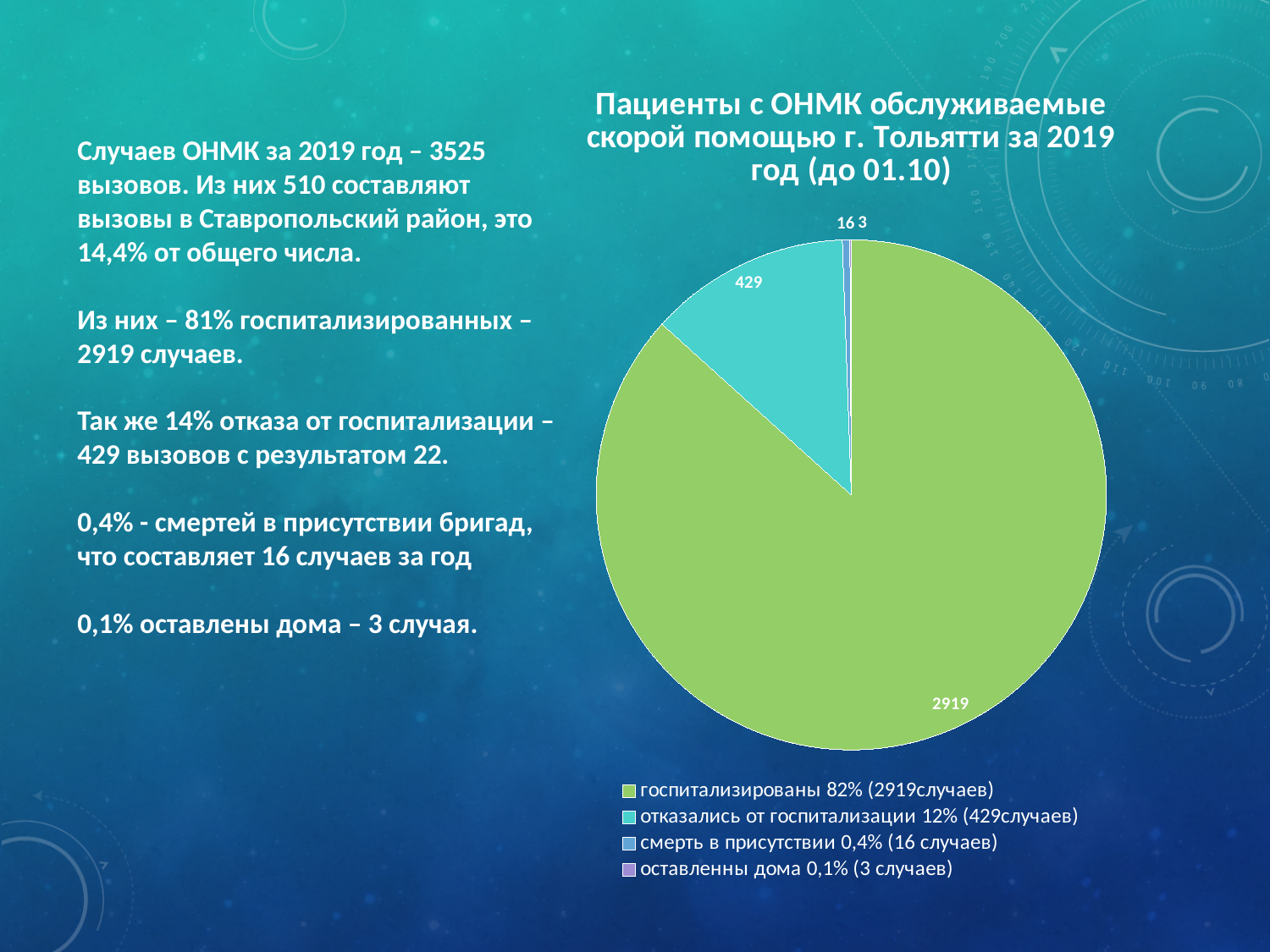
What is the value shown for the 'оставленны дома' slice? 3 What is the title of the pie chart? Пациенты с ОНМК обслуживаемые скорой помощью г. Тольятти за 2019 год (до 01.10) What is the value shown for the 'госпитализированы' slice? 2919 What is the difference between the 'госпитализированы' value and the 'отказались от госпитализации' value? 2490 What type of chart is shown on the slide? pie chart How many slices does the pie chart have? 4 What is the value shown for the 'смерть в присутствии' slice? 16 Which category has the largest slice in the pie chart? госпитализированы How many entries does the legend of the pie chart list? 4 What is the value shown for the 'отказались от госпитализации' slice? 429 According to the legend, what share of the pie does 'отказались от госпитализации' represent? 12% Which category has the smallest slice in the pie chart? оставленны дома